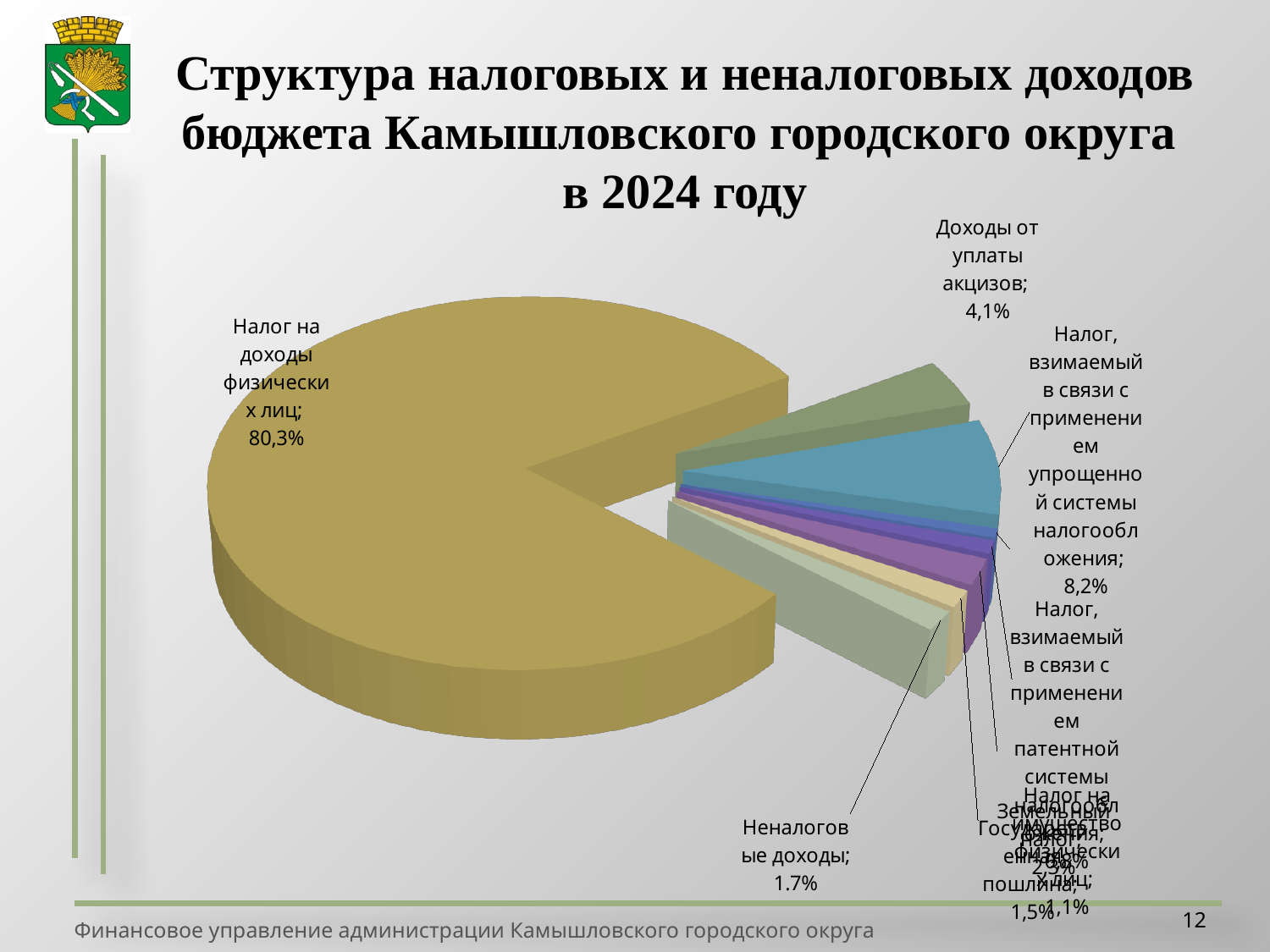
Which year does the chart's title refer to? 2024 What kind of chart is shown on the slide? Pie chart What share is shown for "Неналоговые доходы"? 1.7% What is the title of the chart on the slide? Структура налоговых и неналоговых доходов бюджета Камышловского городского округа в 2024 году Which is larger: the share for "Налог на доходы физических лиц" or the share for "Неналоговые доходы"? Налог на доходы физических лиц Which is larger: the share for "Доходы от уплаты акцизов" or the share for the simplified taxation system tax? Налог, взимаемый в связи с применением упрощенной системы налогообложения Which category has the largest slice of the pie? Налог на доходы физических лиц What share is shown for "Доходы от уплаты акцизов"? 4,1% By how many percentage points does the share of "Налог на доходы физических лиц" exceed the share of the simplified taxation system tax? 72,1% What share is shown for the tax levied under the simplified taxation system ("Налог, взимаемый в связи с применением упрощенной системы налогообложения")? 8,2% What is the difference between the share of the simplified taxation system tax and the share of "Доходы от уплаты акцизов"? 4,1% What share of the pie is labelled for "Налог на доходы физических лиц"? 80,3%